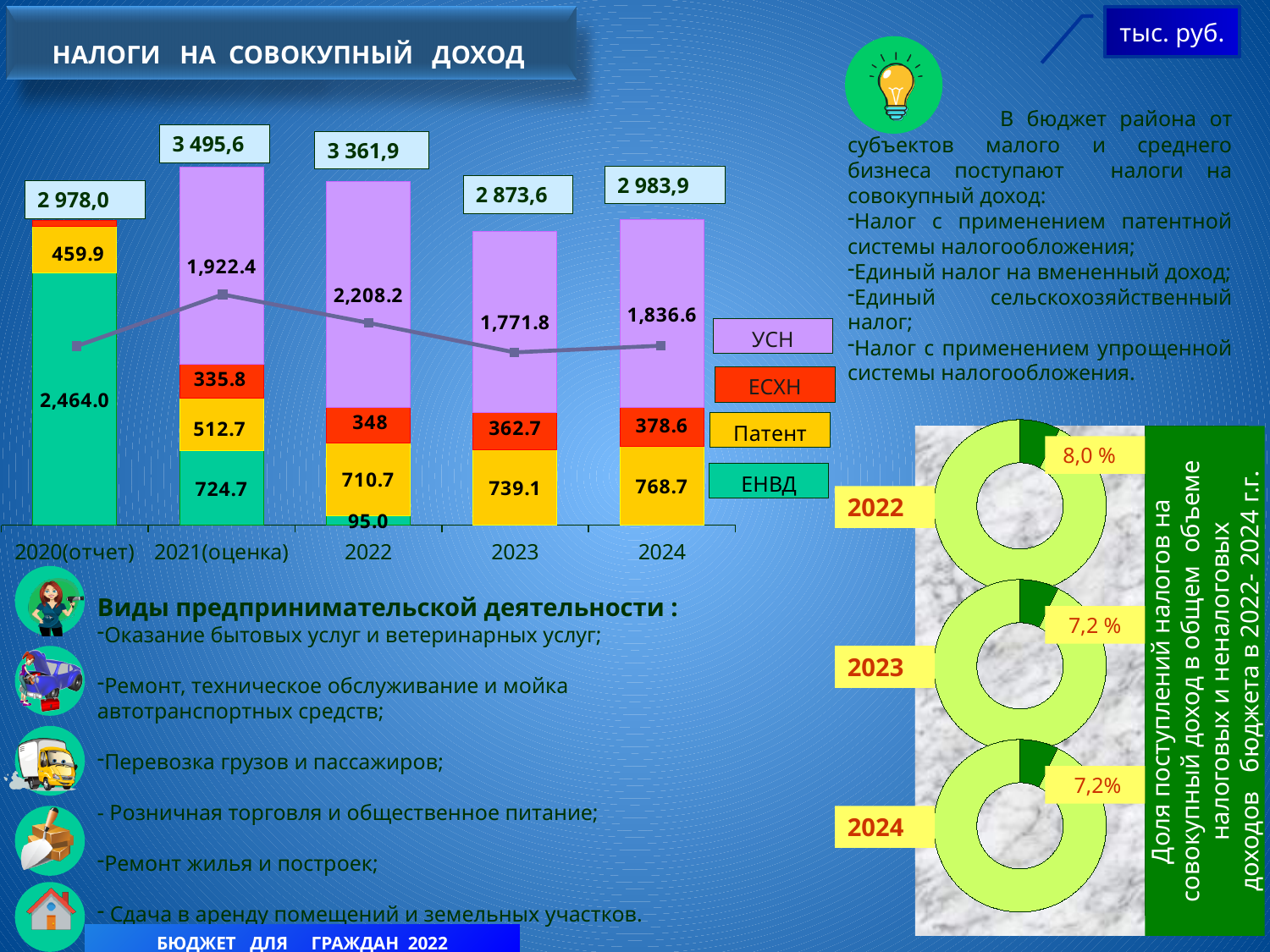
In the donut charts on the right of the slide, what share is shown for 2022? 8,0 % In the stacked bar chart 'НАЛОГИ НА СОВОКУПНЫЙ ДОХОД', what is the ЕНВД value for 2020(отчет)? 2,464.0 What kind of chart is the chart titled 'НАЛОГИ НА СОВОКУПНЫЙ ДОХОД'? Stacked bar chart with a line In the stacked bar chart 'НАЛОГИ НА СОВОКУПНЫЙ ДОХОД', what is the difference between the ЕСХН values for 2024 and 2023? 15.9 In the stacked bar chart 'НАЛОГИ НА СОВОКУПНЫЙ ДОХОД', what is the УСН value for 2022? 2,208.2 How many years are shown on the x axis of the stacked bar chart 'НАЛОГИ НА СОВОКУПНЫЙ ДОХОД'? 5 In the stacked bar chart 'НАЛОГИ НА СОВОКУПНЫЙ ДОХОД', what is the total shown above the 2021(оценка) bar? 3 495,6 How many series does the legend of the stacked bar chart 'НАЛОГИ НА СОВОКУПНЫЙ ДОХОД' list? 4 In the stacked bar chart 'НАЛОГИ НА СОВОКУПНЫЙ ДОХОД', which year has the highest total? 2021(оценка) In the stacked bar chart 'НАЛОГИ НА СОВОКУПНЫЙ ДОХОД', which is larger: the УСН value for 2021(оценка) or for 2024? 2021(оценка) In the stacked bar chart 'НАЛОГИ НА СОВОКУПНЫЙ ДОХОД', what is the Патент value for 2024? 768.7 In the stacked bar chart 'НАЛОГИ НА СОВОКУПНЫЙ ДОХОД', which year has the lowest total? 2023